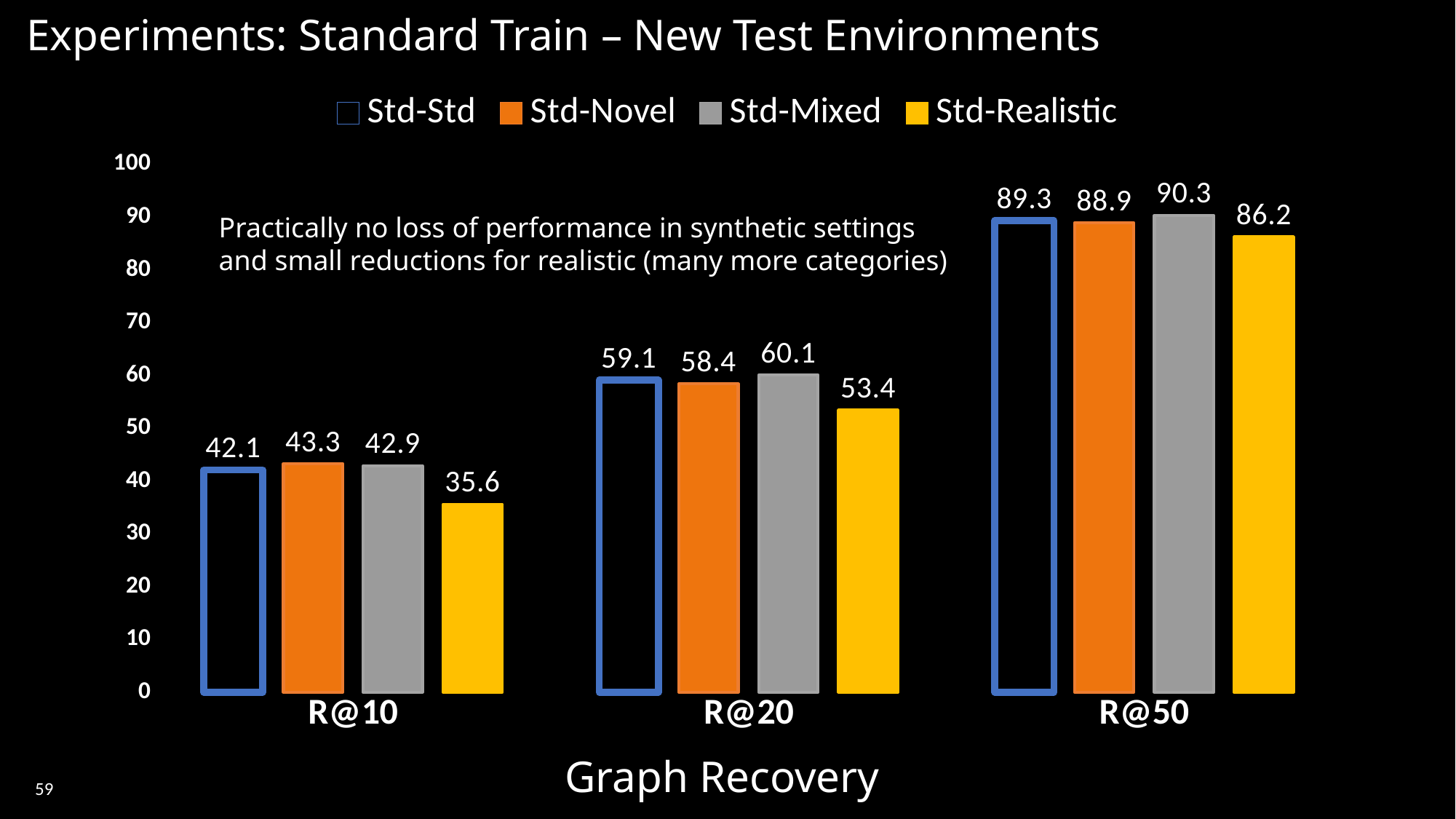
What is the Std-Novel value for R@20? 58.4 How many categories are shown on the x axis? 3 What is the difference between the Std-Std and Std-Realistic values for R@10? 6.5 What kind of chart is shown on the slide? Bar chart Which series has the highest value for R@50? Std-Mixed Which is larger for R@50: Std-Std or Std-Realistic? Std-Std What is the Std-Std value for R@10? 42.1 What is the difference between the Std-Mixed and Std-Realistic values for R@20? 6.7 Which series has the lowest value for R@10? Std-Realistic How many series does the legend list? 4 What is the Std-Realistic value for R@20? 53.4 What is the Std-Mixed value for R@50? 90.3